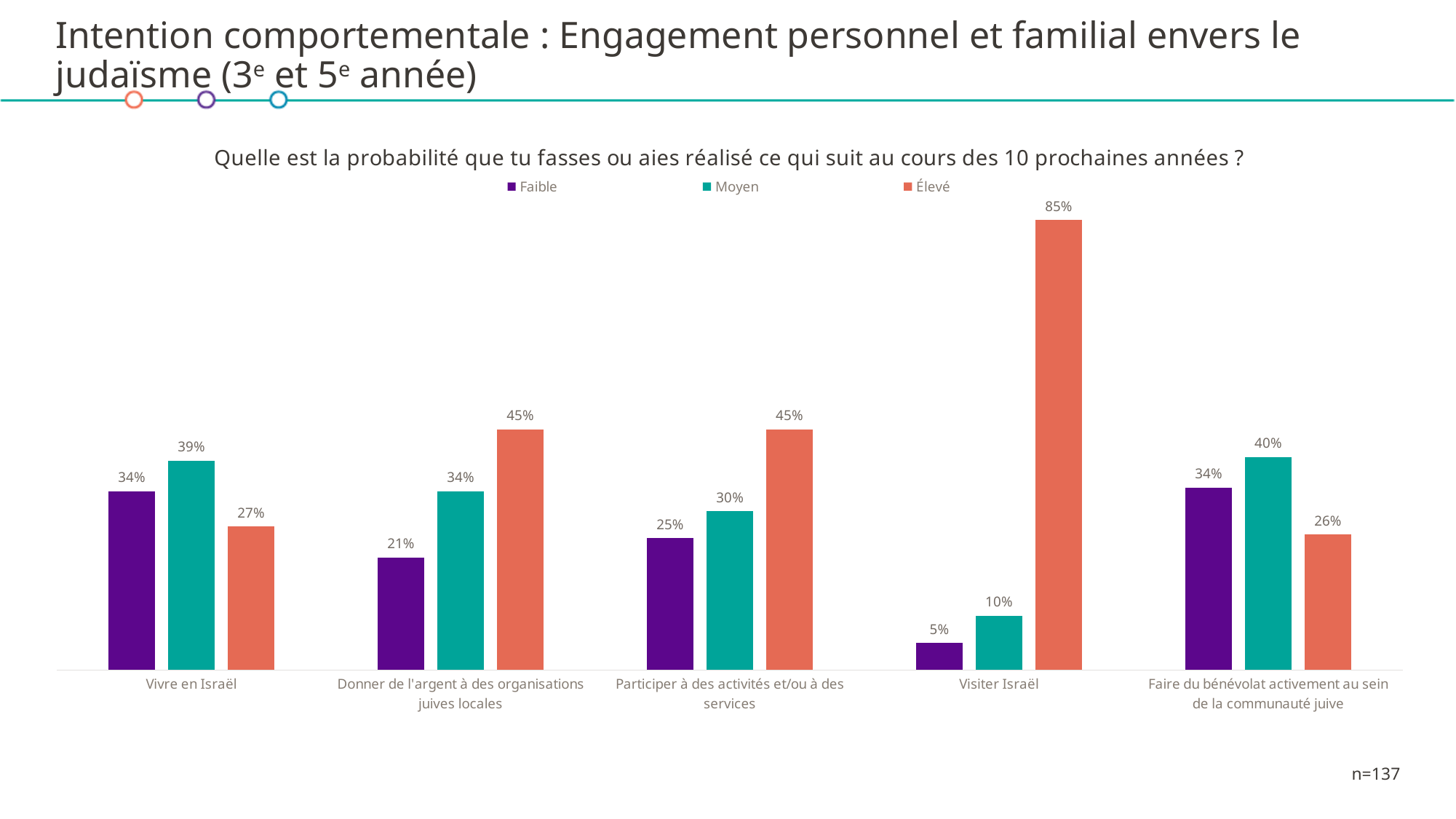
Which is larger for Vivre en Israël: the Moyen value or the Élevé value? Moyen How many series does the legend list? 3 What is the value of the Faible series for Donner de l'argent à des organisations juives locales? 21% What is the value of the Élevé series for Visiter Israël? 85% What is the value of the Moyen series for Faire du bénévolat activement au sein de la communauté juive? 40% Which category has the highest Élevé value? Visiter Israël What kind of chart is shown on the slide? Bar chart What is the difference between the Élevé values for Participer à des activités et/ou à des services and Faire du bénévolat activement au sein de la communauté juive? 19% What sample size is noted on the slide? n=137 What is the difference between the Élevé and Faible values for Visiter Israël? 80% Which category has the lowest Faible value? Visiter Israël How many categories are shown on the x axis? 5